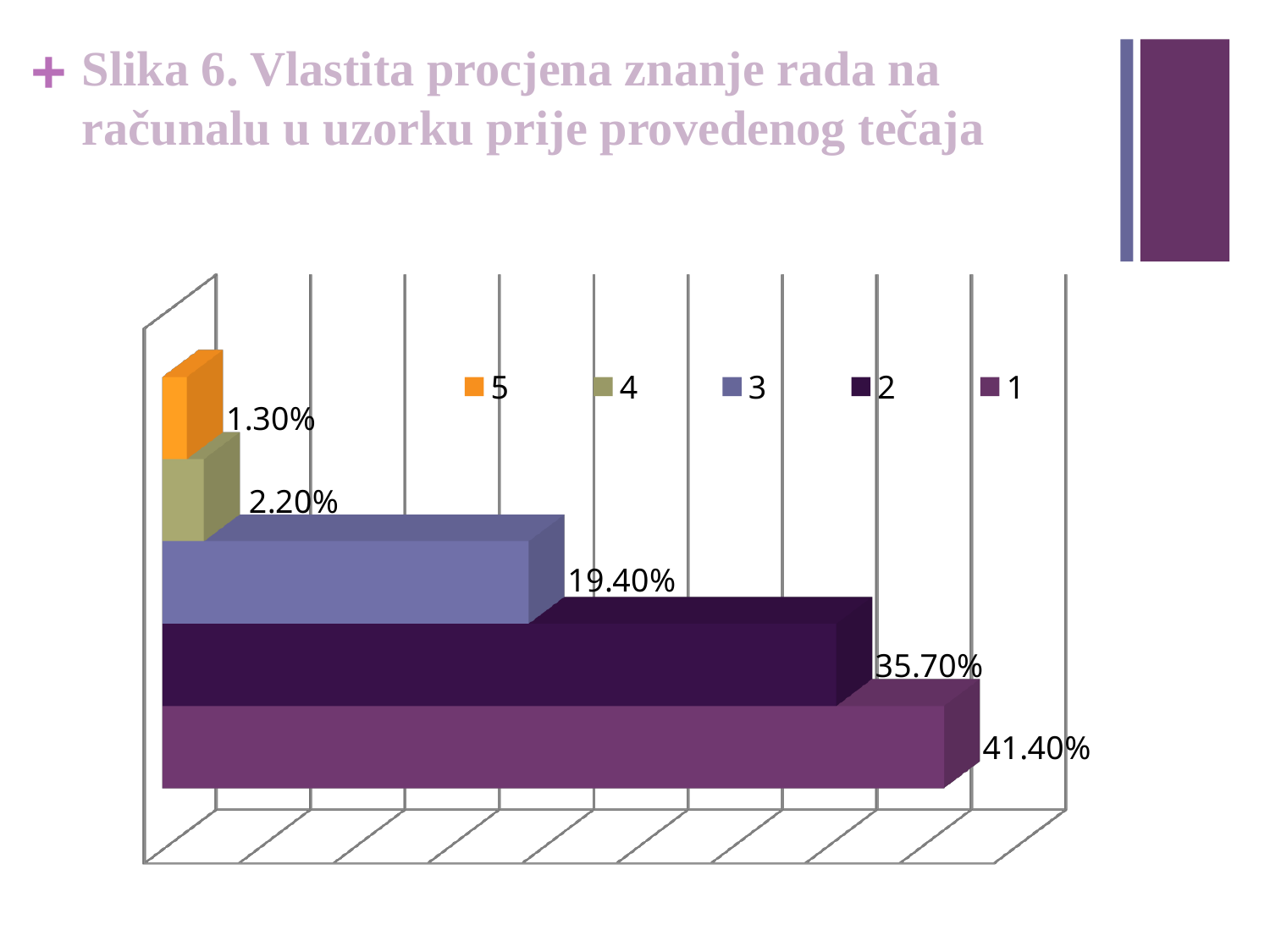
What value is shown for series 4? 2.20% What value is shown for series 2? 35.70% Which series has the lowest value? 5 What colour is the bar for series 5? Orange What kind of chart is shown on the slide? Bar chart What is the difference between the values for series 1 and series 2? 5.70% What value is shown for series 3? 19.40% Which series has the highest value? 1 What value is shown for series 1? 41.40% Which is larger, the value for series 3 or the value for series 4? 3 What value is shown for series 5? 1.30% How many series does the legend list? 5